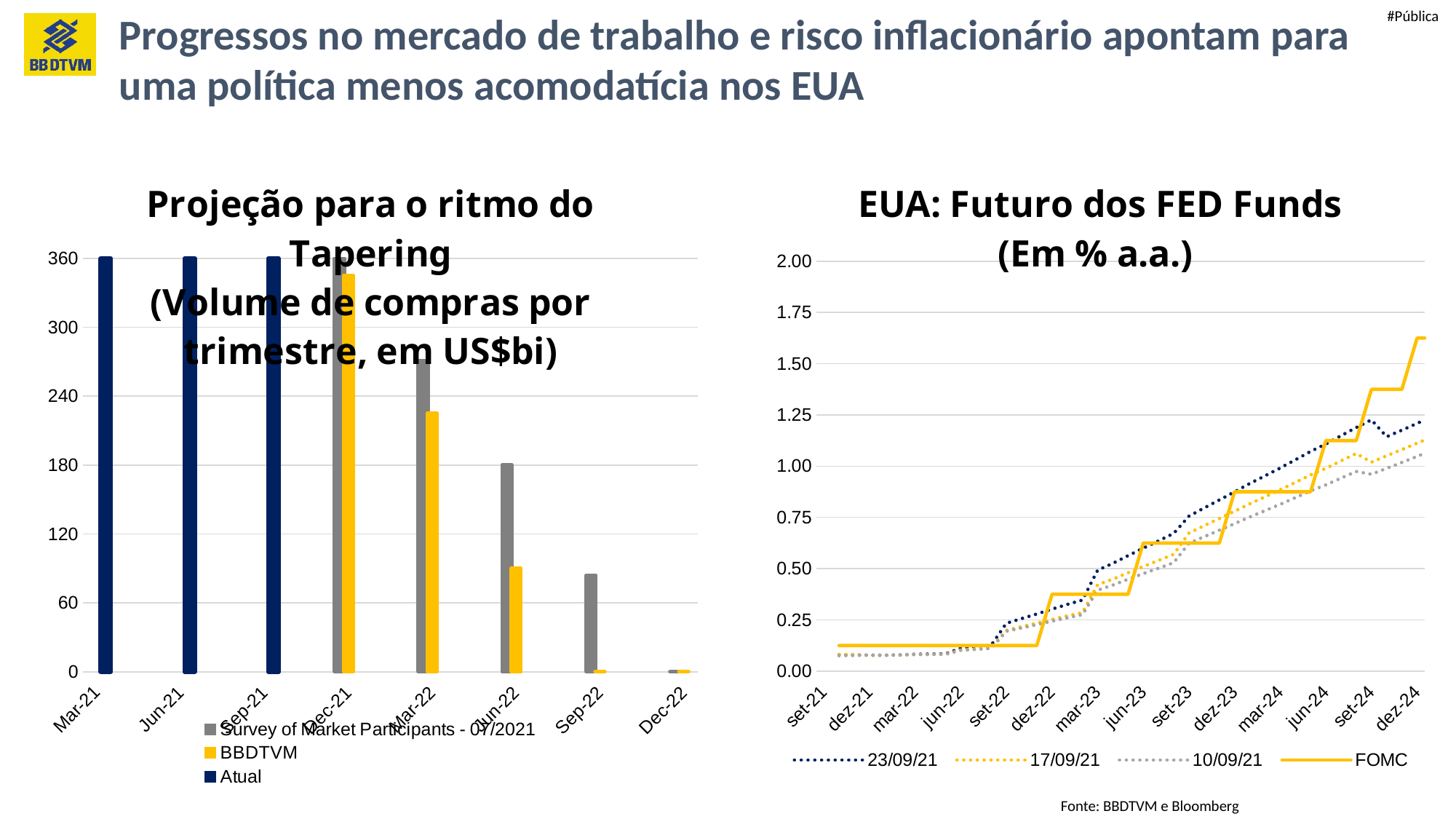
In the left chart, 'Projeção para o ritmo do Tapering', how many series does the legend list? 3 In the right chart, 'EUA: Futuro dos FED Funds', which series has the highest value at dez-24? FOMC In the left chart, 'Projeção para o ritmo do Tapering', is the 'BBDTVM' value for Jun-22 greater or less than 120? less In the right chart, 'EUA: Futuro dos FED Funds', is the FOMC value at dez-24 greater or less than 1.50? greater In the left chart, 'Projeção para o ritmo do Tapering', how many categories are shown on the x axis? 8 What kind of chart is the left chart, 'Projeção para o ritmo do Tapering'? bar chart In the right chart, 'EUA: Futuro dos FED Funds', does the FOMC series rise or fall from set-21 to dez-24? rise In the left chart, 'Projeção para o ritmo do Tapering', which series has the larger value for Mar-22: 'Survey of Market Participants - 07/2021' or 'BBDTVM'? Survey of Market Participants - 07/2021 In the right chart, 'EUA: Futuro dos FED Funds', how many series does the legend list? 4 What kind of chart is the right chart, 'EUA: Futuro dos FED Funds'? line chart In the left chart, 'Projeção para o ritmo do Tapering', what is the value of the 'Atual' series for Mar-21? 360 In the left chart, 'Projeção para o ritmo do Tapering', is the 'Survey of Market Participants - 07/2021' value for Jun-22 greater or less than 120? greater